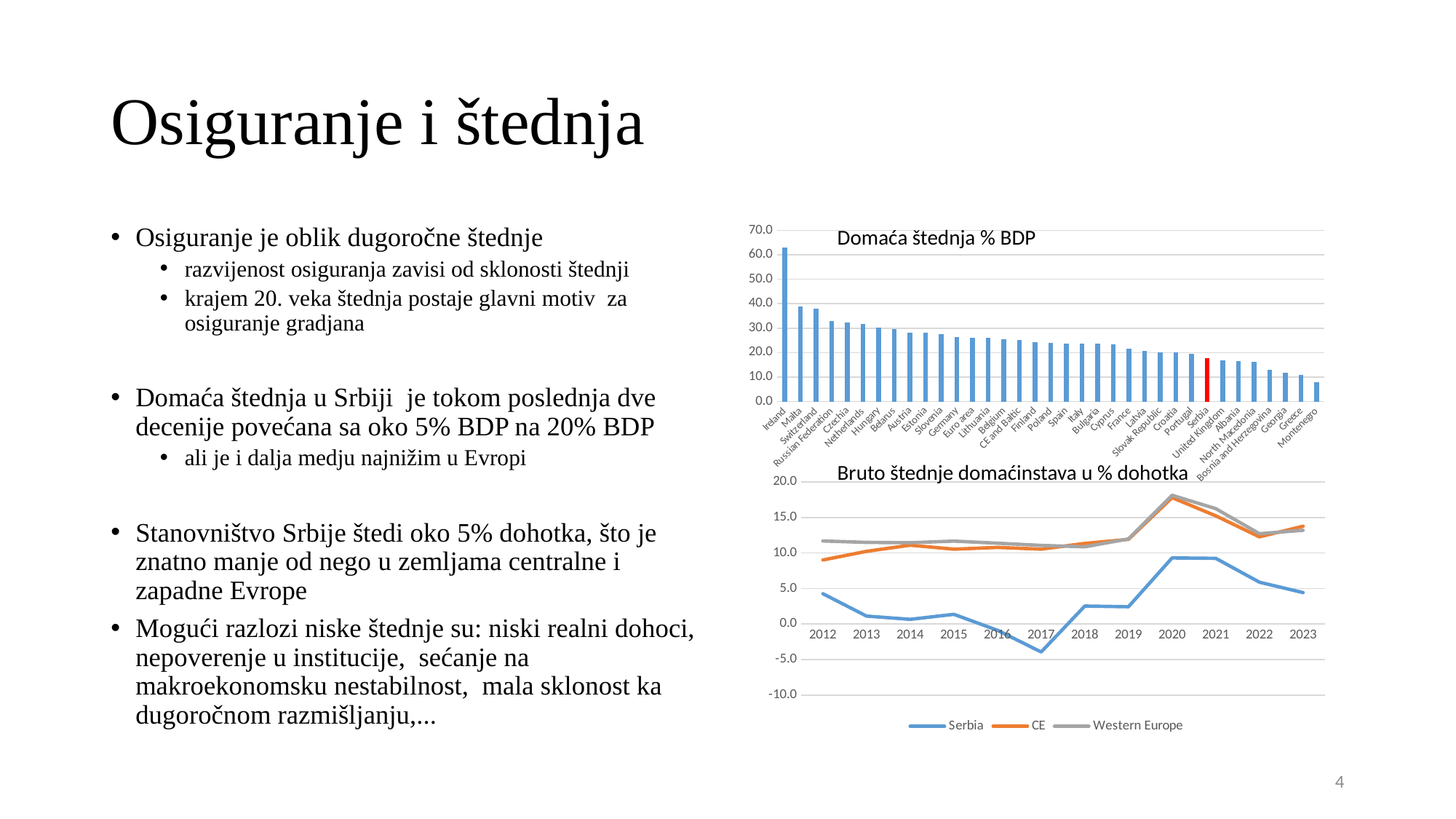
In the 'Domaća štednja % BDP' chart, which bar is coloured red? Serbia How many years are shown on the x axis of the 'Bruto štednje domaćinstava u % dohotka' chart? 12 In the 'Domaća štednja % BDP' chart, which country has the highest value? Ireland How many series does the legend of the 'Bruto štednje domaćinstava u % dohotka' chart list? 3 In the 'Domaća štednja % BDP' chart, is the value for Serbia greater or less than 20? less In the 'Domaća štednja % BDP' chart, is the value for Ireland greater or less than 50? greater What kind of chart is the 'Bruto štednje domaćinstava u % dohotka' chart? line chart What kind of chart is the 'Domaća štednja % BDP' chart? bar chart In the 'Bruto štednje domaćinstava u % dohotka' chart, does the Serbia line rise or fall from 2017 to 2020? rise In the 'Bruto štednje domaćinstava u % dohotka' chart, which is larger in 2020, Serbia or Western Europe? Western Europe In the 'Domaća štednja % BDP' chart, which country has the lowest value? Montenegro In the 'Bruto štednje domaćinstava u % dohotka' chart, is the value for Serbia in 2017 greater or less than 0? less